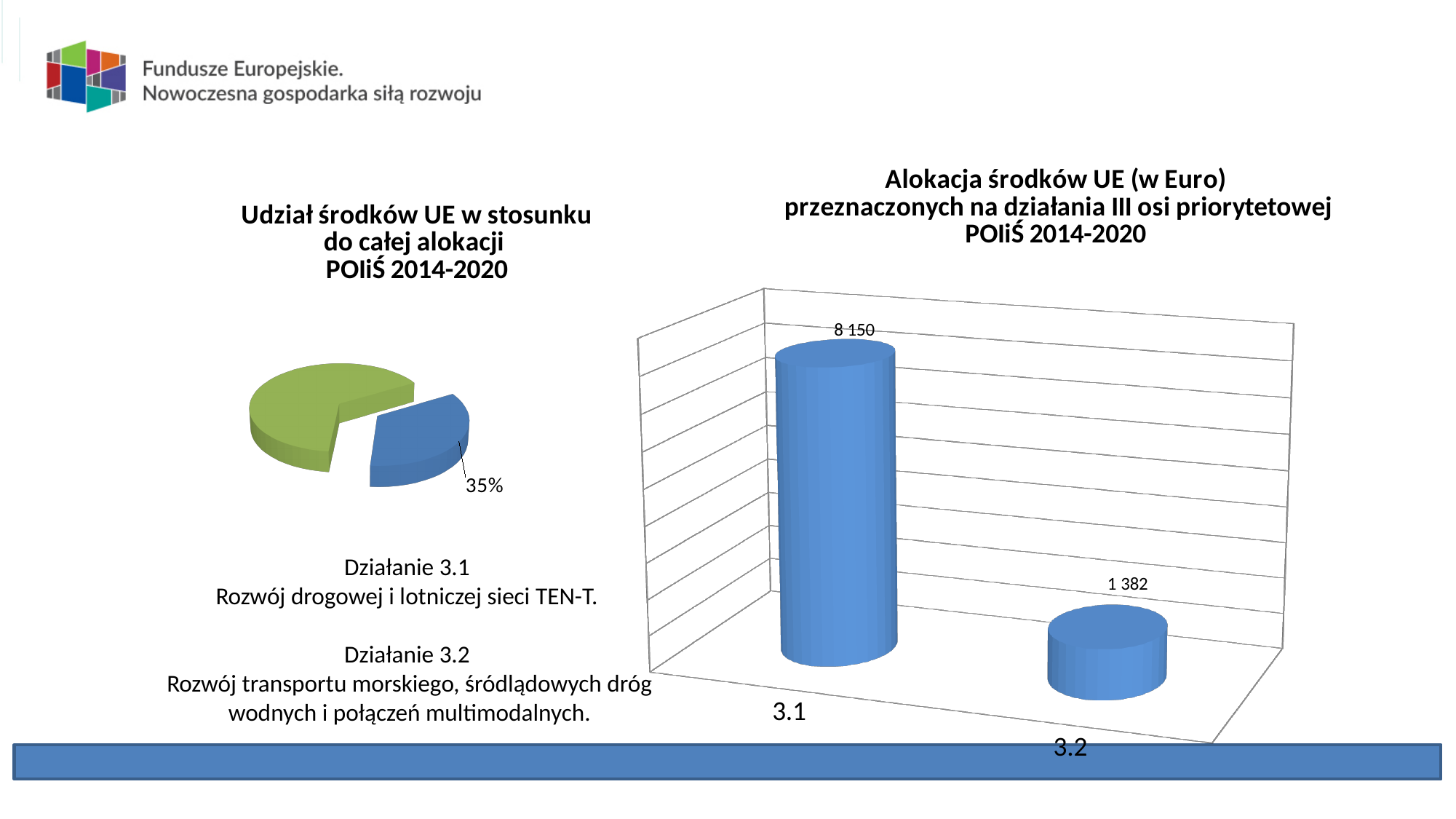
In the bar chart on the right, what is the value for category 3.1? 8 150 In the bar chart on the right, what is the difference between the values for 3.1 and 3.2? 6 768 What kind of chart is the chart on the left of the slide? Pie chart What is the title of the chart on the right of the slide? Alokacja środków UE (w Euro) przeznaczonych na działania III osi priorytetowej POIiŚ 2014-2020 How many categories are shown in the bar chart on the right? 2 In the pie chart on the left, what share is shown for the blue slice? 35% In the bar chart on the right, which is larger: the value for 3.1 or the value for 3.2? 3.1 In the bar chart on the right, which category has the lowest value? 3.2 In the bar chart on the right, which category has the highest value? 3.1 What kind of chart is the chart on the right of the slide? Bar chart In the pie chart on the left, which slice is larger: the green slice or the blue slice? The green slice In the bar chart on the right, what is the value for category 3.2? 1 382